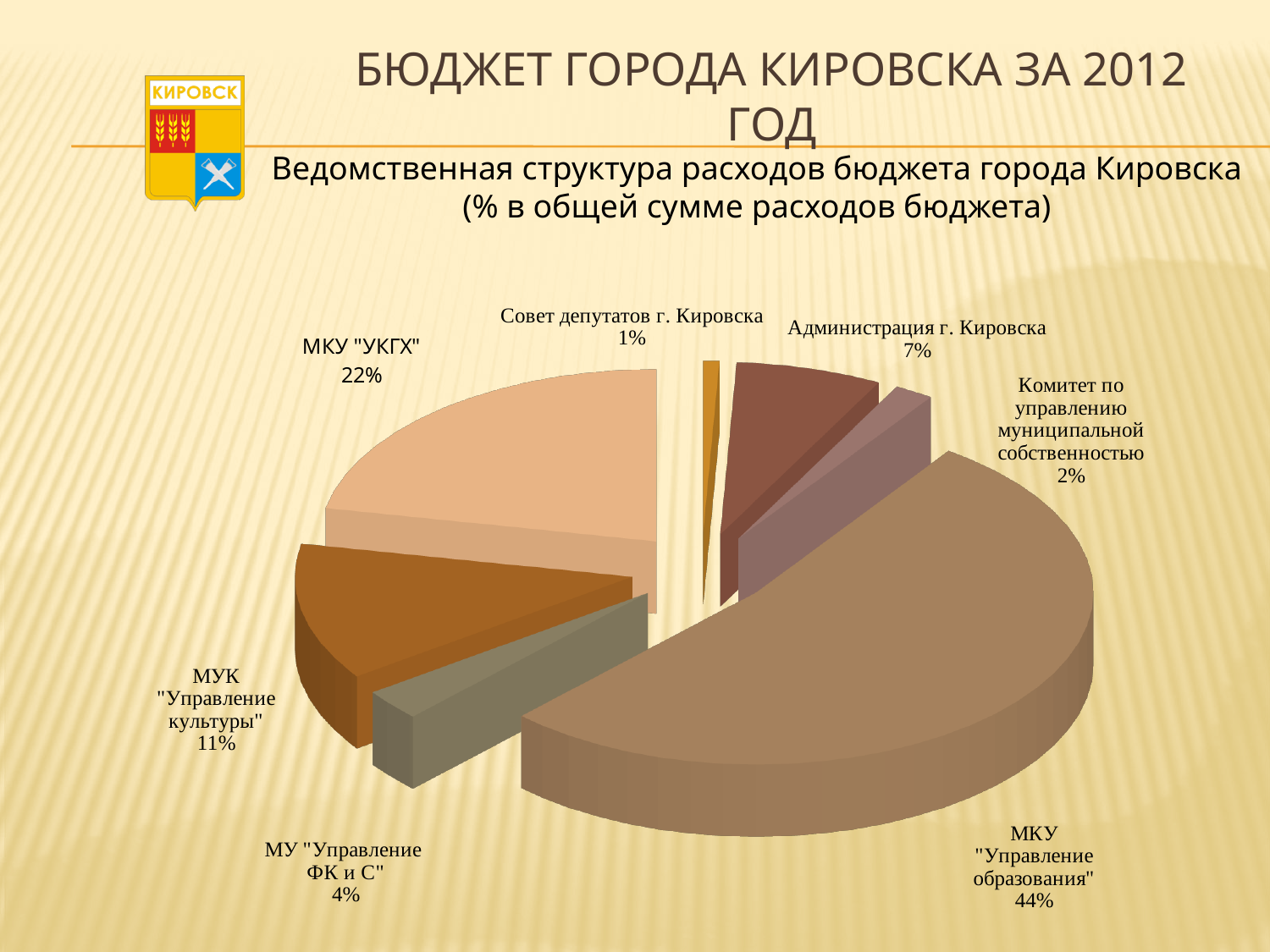
What is the value shown for Комитет по управлению муниципальной собственностью? 2% What is the subtitle of the chart shown on the slide? Ведомственная структура расходов бюджета города Кировска (% в общей сумме расходов бюджета) What share of budget expenditures does МКУ "Управление образования" account for? 44% What is the value shown for МКУ "УКГХ"? 22% How many categories (slices) does the pie chart have? 7 Which category has the largest slice of the pie? МКУ "Управление образования" What is the difference between the values for МКУ "Управление образования" and МКУ "УКГХ"? 22% Which is larger: the value for МУК "Управление культуры" or the value for МУ "Управление ФК и С"? МУК "Управление культуры" What is the value shown for Администрация г. Кировска? 7% Which category has the smallest slice of the pie? Совет депутатов г. Кировска What kind of chart is shown on the slide? Pie chart What is the value shown for МУК "Управление культуры"? 11%